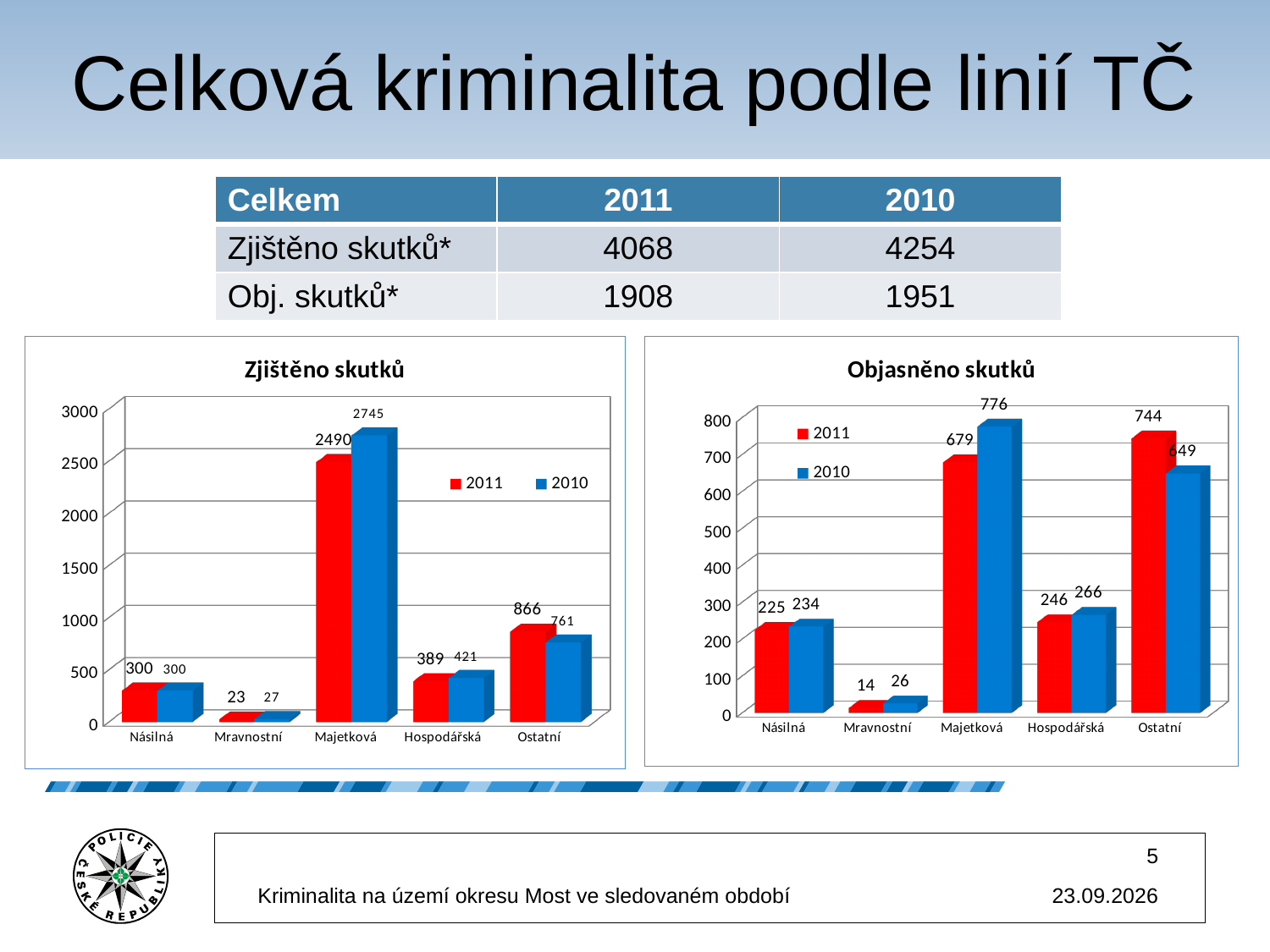
What type of chart is the "Objasněno skutků" chart? Bar chart In the "Objasněno skutků" chart, what is the 2010 value for Majetková? 776 In the "Zjištěno skutků" chart, which is larger for Majetková: the 2011 value or the 2010 value? 2010 In the "Zjištěno skutků" chart, how many categories are shown on the x axis? 5 In the "Objasněno skutků" chart, what is the difference between the 2010 and 2011 values for Mravnostní? 12 In the "Objasněno skutků" chart, what is the 2011 value for Ostatní? 744 How many series does the legend of the "Objasněno skutků" chart list? 2 In the "Zjištěno skutků" chart, what is the difference between the 2011 and 2010 values for Ostatní? 105 In the "Zjištěno skutků" chart, what is the 2010 value for Hospodářská? 421 In the "Zjištěno skutků" chart, which category has the lowest 2011 value? Mravnostní In the "Zjištěno skutků" chart, what is the 2011 value for Majetková? 2490 In the "Objasněno skutků" chart, which category has the highest 2011 value? Ostatní